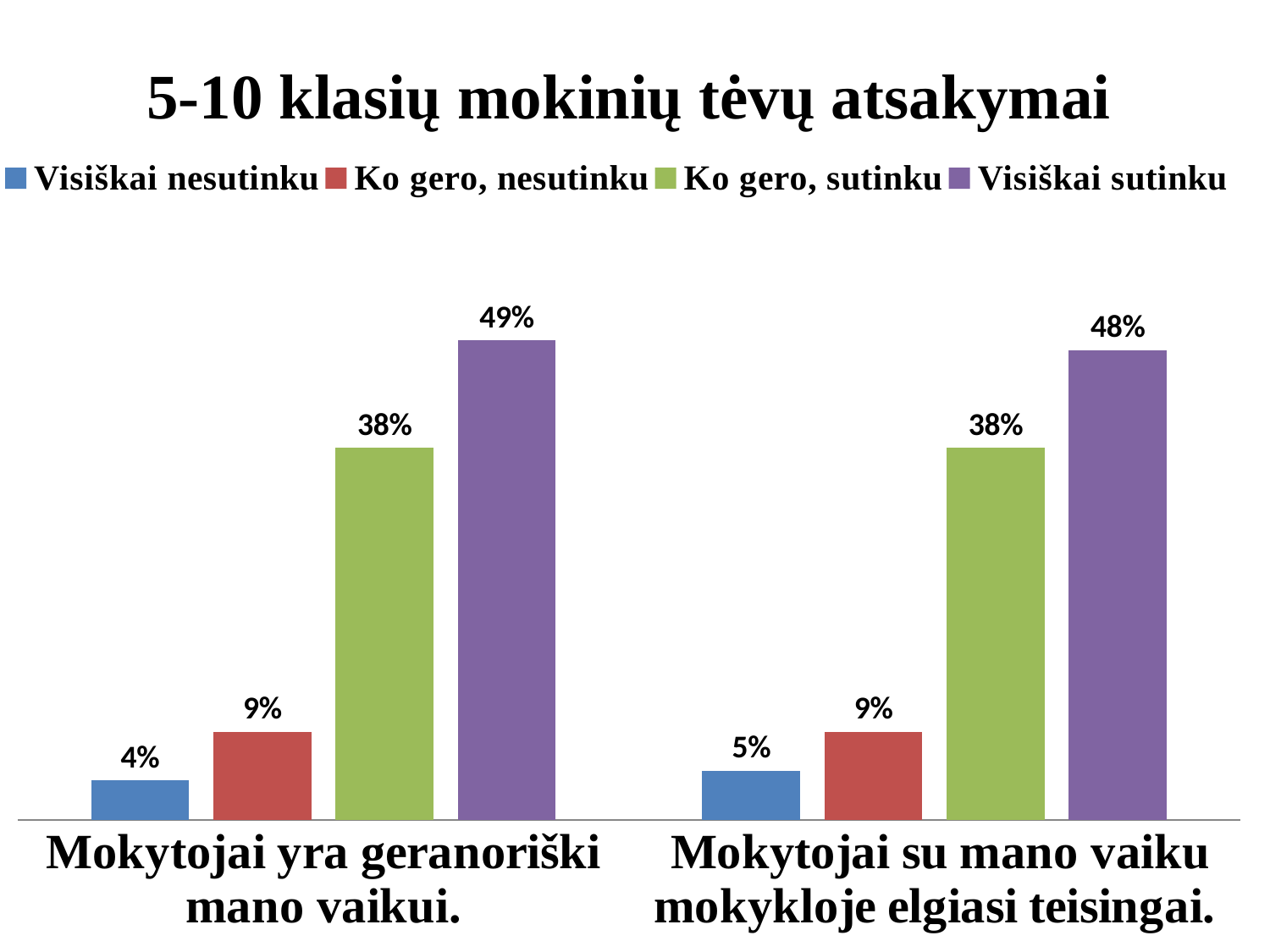
Which is larger: "Visiškai sutinku" for "Mokytojai yra geranoriški mano vaikui." or "Visiškai sutinku" for "Mokytojai su mano vaiku mokykloje elgiasi teisingai."? Mokytojai yra geranoriški mano vaikui. Which series has the lowest value in the category "Mokytojai yra geranoriški mano vaikui."? Visiškai nesutinku What is the difference between "Ko gero, nesutinku" and "Visiškai nesutinku" in the category "Mokytojai su mano vaiku mokykloje elgiasi teisingai."? 4% What is the value for "Visiškai nesutinku" in the category "Mokytojai su mano vaiku mokykloje elgiasi teisingai."? 5% What is the value for "Visiškai sutinku" in the category "Mokytojai yra geranoriški mano vaikui."? 49% What is the value for "Ko gero, sutinku" in the category "Mokytojai yra geranoriški mano vaikui."? 38% What kind of chart is shown on the slide? Bar chart How many series does the legend list? 4 Which series has the highest value in the category "Mokytojai su mano vaiku mokykloje elgiasi teisingai."? Visiškai sutinku How many categories are shown on the x axis? 2 What is the title of the chart? 5-10 klasių mokinių tėvų atsakymai What is the difference between "Visiškai sutinku" and "Ko gero, sutinku" in the category "Mokytojai yra geranoriški mano vaikui."? 11%